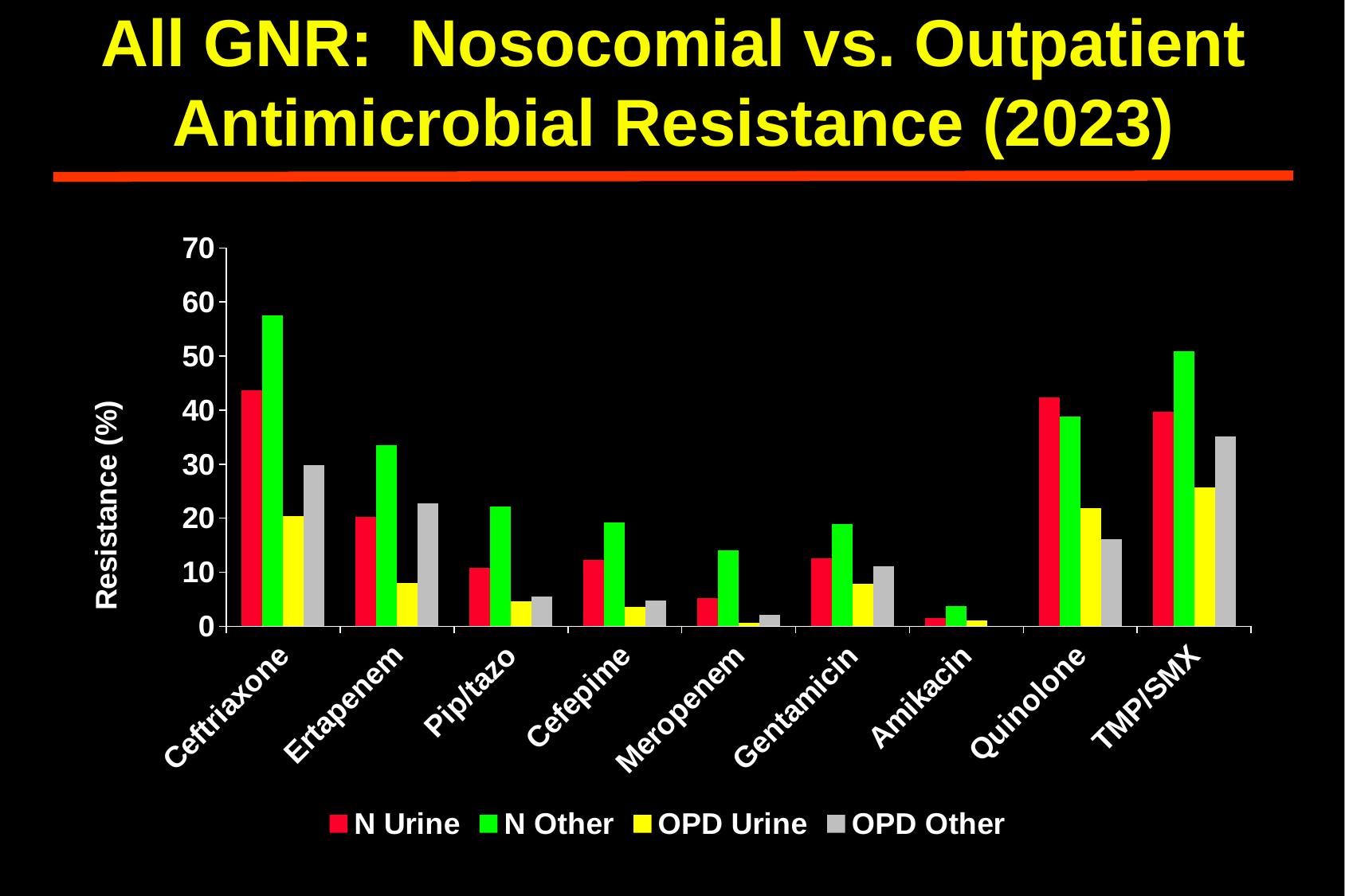
Is the N Other value for Ceftriaxone greater or less than 50? greater For Ceftriaxone, which is larger: the N Urine value or the OPD Urine value? N Urine For TMP/SMX, which is larger: the N Other value or the OPD Other value? N Other What kind of chart is shown on the slide? bar chart Is the N Other value for Meropenem greater or less than 10? greater What is the label on the y axis? Resistance (%) How many series does the legend list? 4 Is the N Other value for Ertapenem greater or less than 30? greater Which antibiotic has the lowest N Other resistance? Amikacin How many antibiotics are shown along the x axis? 9 Which antibiotic has the highest N Other resistance? Ceftriaxone